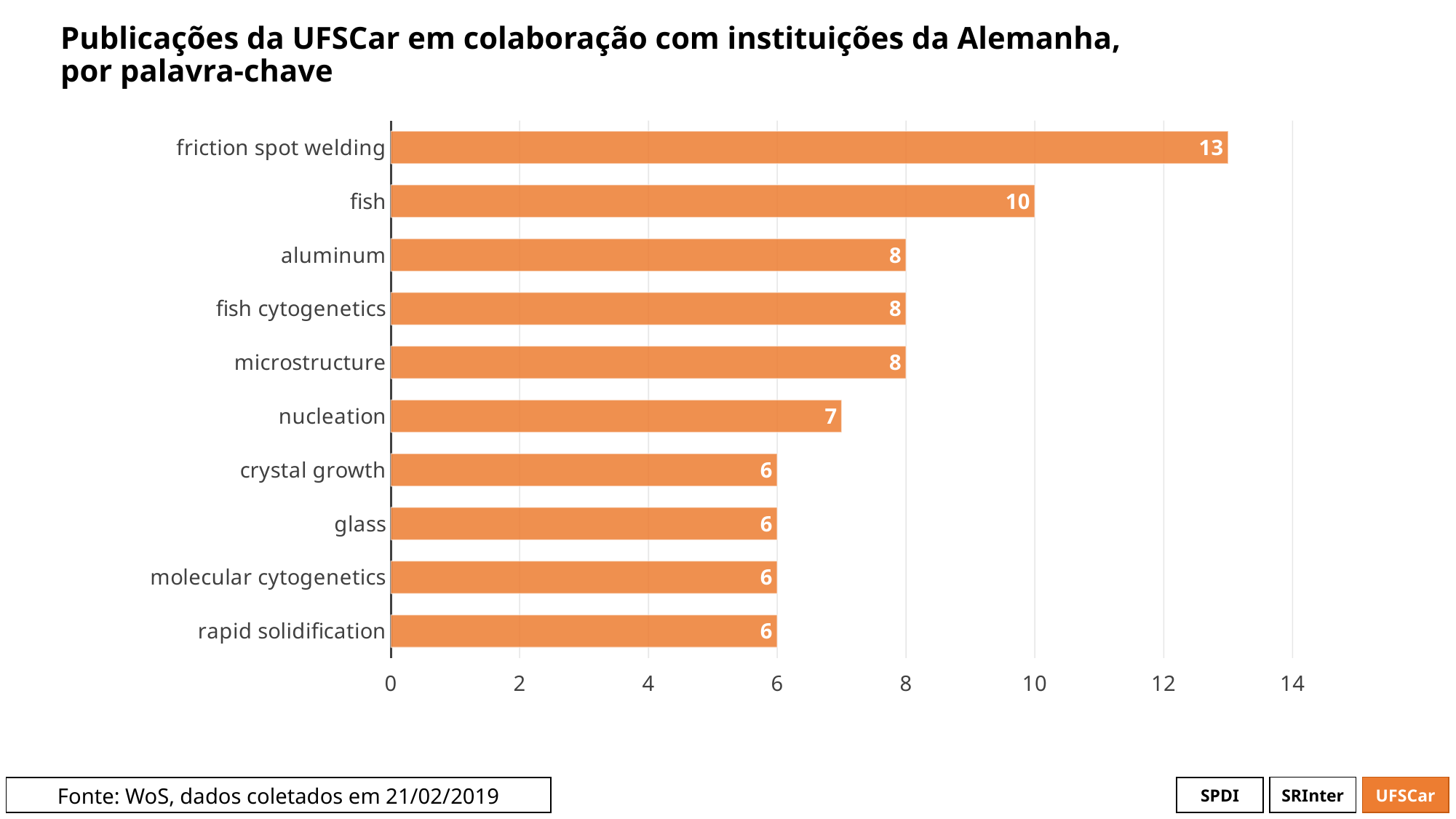
What is the value for nucleation? 7 What is the difference between the values for aluminum and crystal growth? 2 What is the value for friction spot welding? 13 What is the source of the data cited on the slide? WoS, dados coletados em 21/02/2019 Is the value for nucleation greater or less than 8? less Which keyword has the highest number of publications? friction spot welding What is the difference between the values for friction spot welding and fish? 3 What kind of chart is shown on the slide? bar chart What is the value for fish? 10 What is the value for molecular cytogenetics? 6 Which is larger, the value for fish or the value for microstructure? fish How many keywords are shown in the chart? 10